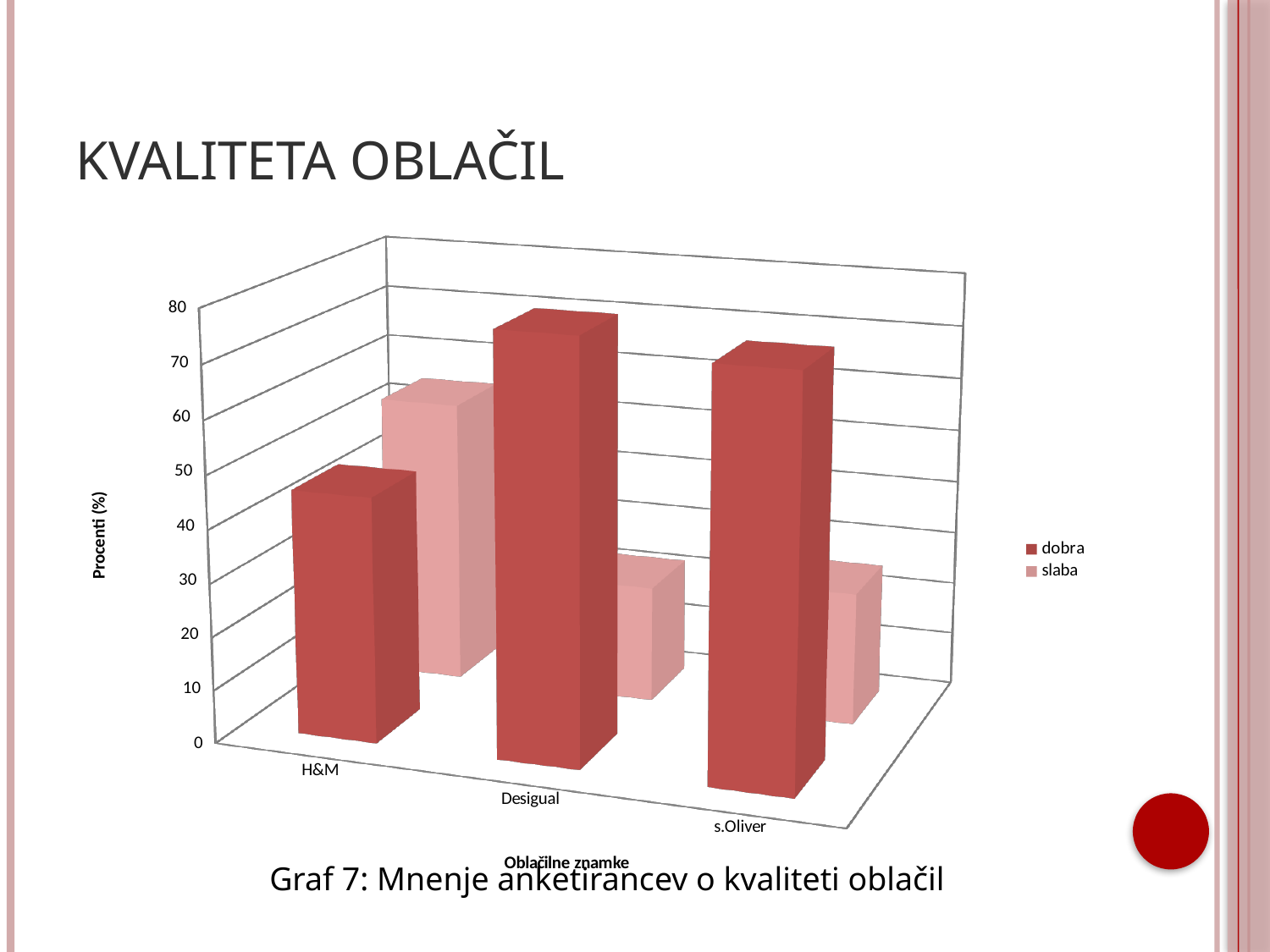
What kind of chart is shown on the slide? bar chart What is the title of the vertical axis? Procenti (%) How many clothing brands (categories) are shown on the x axis? 3 What are the two series named in the legend? dobra, slaba For Desigual, which is larger: the 'dobra' value or the 'slaba' value? dobra How many series does the legend list? 2 For H&M, which is larger: the 'dobra' value or the 'slaba' value? slaba Which brand has the highest 'slaba' value? H&M Is the 'slaba' value for Desigual greater or less than 40? less Is the 'dobra' value for H&M greater or less than 60? less Which brand has the lowest 'dobra' value? H&M For s.Oliver, which is larger: the 'dobra' value or the 'slaba' value? dobra